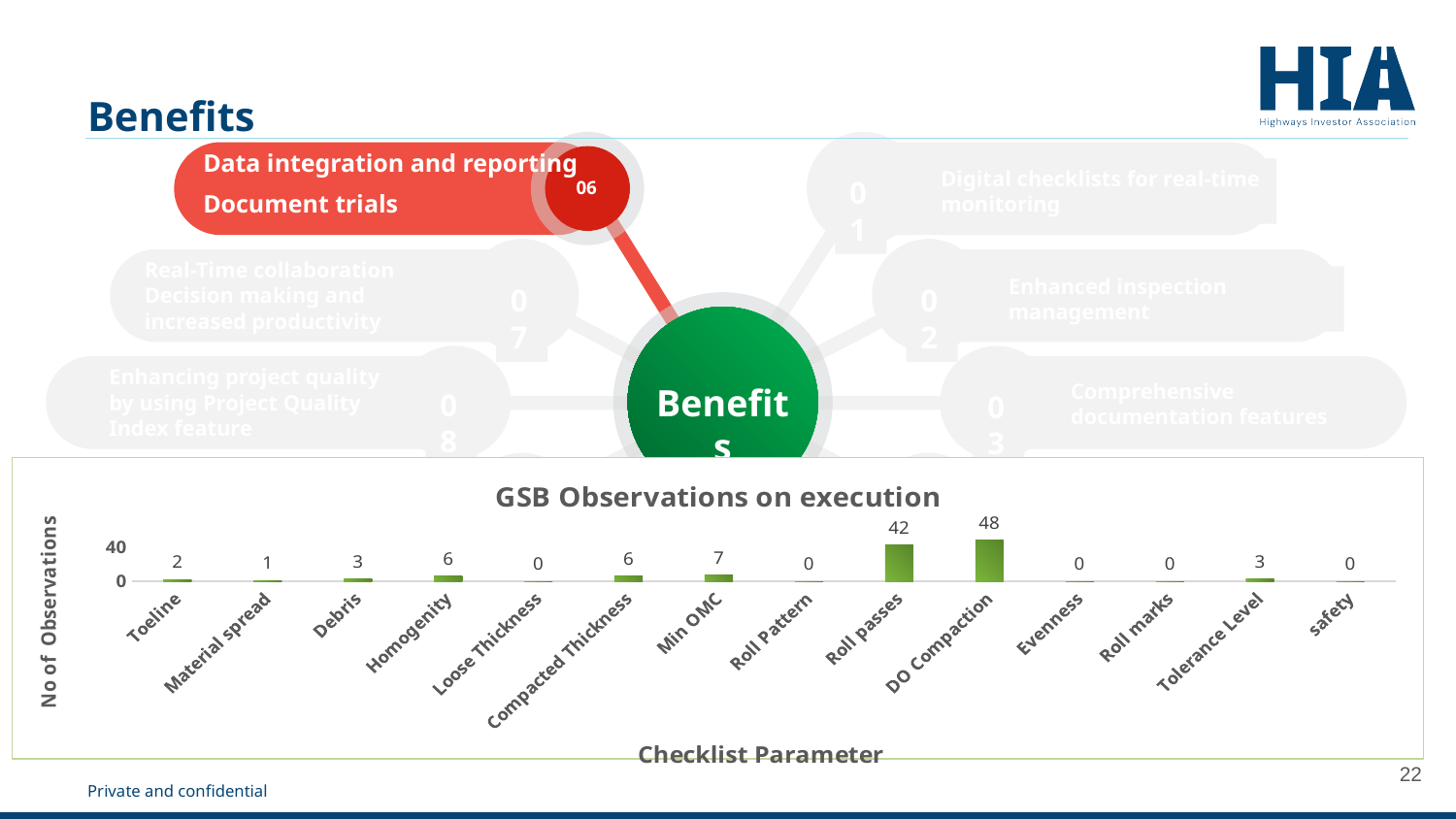
Which checklist parameter has the highest number of observations? DO Compaction Is the value for Roll passes greater or less than 40? greater What type of chart is shown on the slide? bar chart Which has more observations, Homogenity or Debris? Homogenity What is the difference in observations between DO Compaction and Roll passes? 6 What is the number of observations for DO Compaction? 48 What is the number of observations for Min OMC? 7 What is the title of the chart on the slide? GSB Observations on execution What is the number of observations for Roll passes? 42 What is the number of observations for Material spread? 1 What is the label of the vertical axis of the chart? No of Observations How many checklist parameters are plotted in the chart? 14